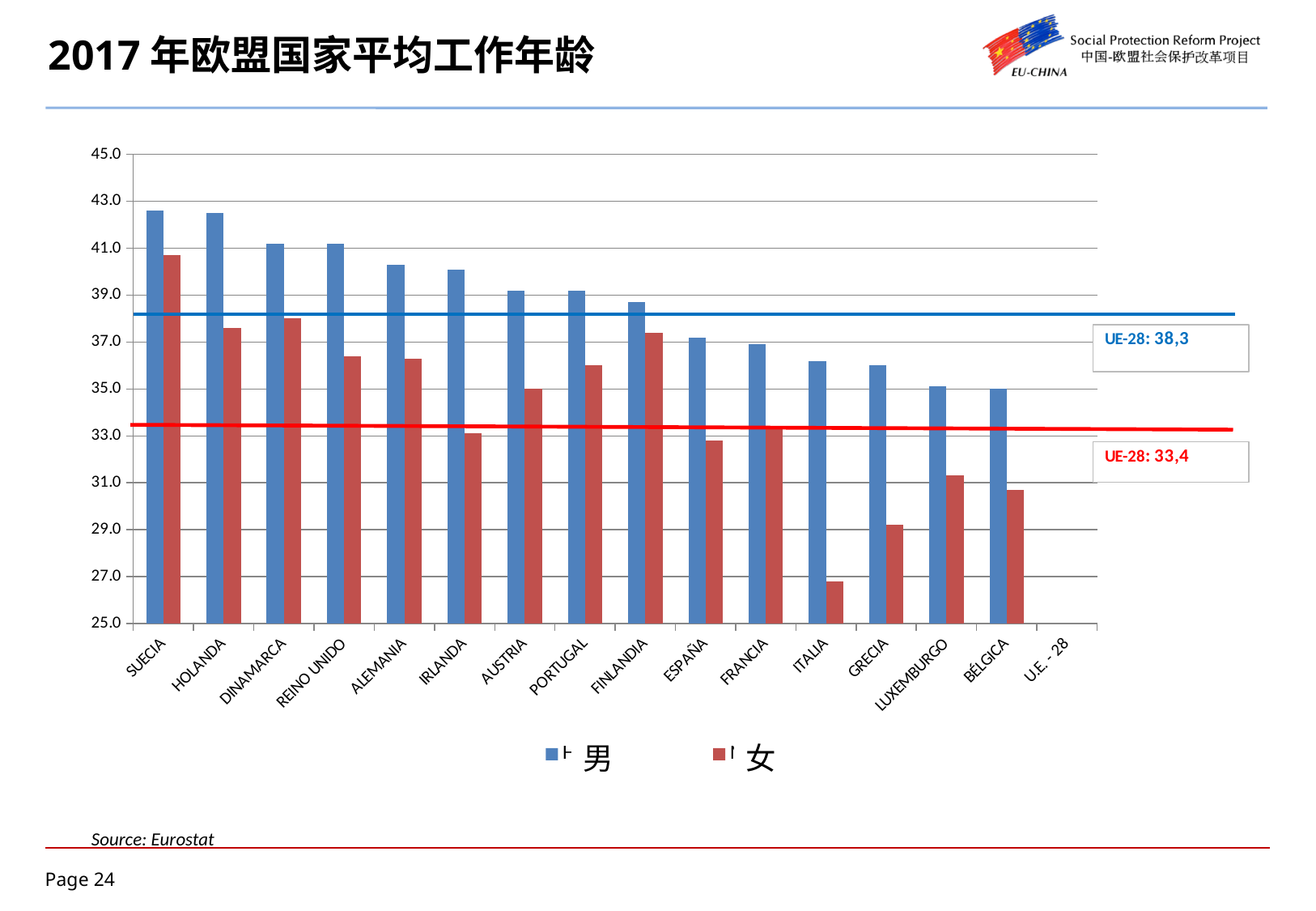
What value does the blue horizontal reference line for UE-28 show? 38,3 Which country has the lowest value for the 女 (female) series? ITALIA Is the 男 (male) value for SUECIA greater or less than 41.0? greater Is the 女 (female) value for GRECIA greater or less than 31.0? less What is the difference between the UE-28 male reference value (38,3) and the UE-28 female reference value (33,4)? 4,9 What kind of chart is shown on the slide? bar chart Which country has the highest value for the 女 (female) series? SUECIA Which is larger in ITALIA, the 男 (male) value or the 女 (female) value? 男 (male) What value does the red horizontal reference line for UE-28 show? 33,4 How many categories are labelled on the x axis? 16 Do the 男 (male) values rise or fall moving from left to right along the x axis? fall How many series does the legend list? 2